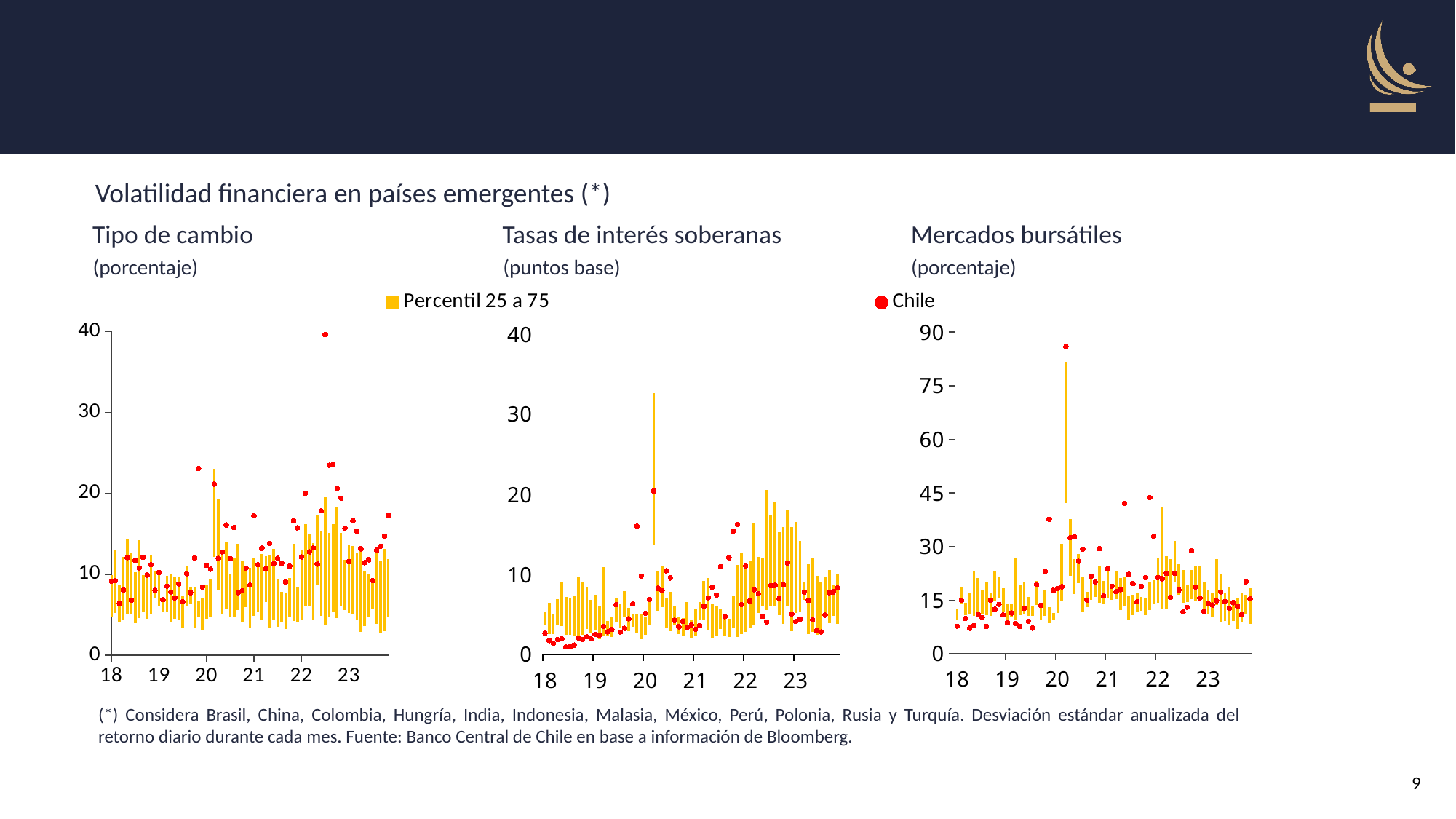
What are the two legend entries shown on the slide? Percentil 25 a 75 and Chile In the 'Tasas de interés soberanas' chart, is the highest Chile point greater or less than 10? greater In the 'Mercados bursátiles' chart, what is the highest value shown on the vertical axis? 90 What is the overall title of the slide's charts? Volatilidad financiera en países emergentes (*) How many charts are shown on the slide? 3 How many series does the shared legend list? 2 In the 'Tasas de interés soberanas' chart, in which year label on the x axis does the tallest Percentil 25 a 75 bar occur? 20 In the 'Mercados bursátiles' chart, is the highest Chile point greater or less than 75? greater In the 'Tipo de cambio' chart, how many year labels are shown on the x axis? 6 In the 'Tasas de interés soberanas' chart, what unit is given in parentheses under the title? puntos base In the 'Mercados bursátiles' chart, in which year label on the x axis does the tallest Percentil 25 a 75 bar occur? 20 In the 'Tipo de cambio' chart, is the highest Chile point greater or less than 30? greater